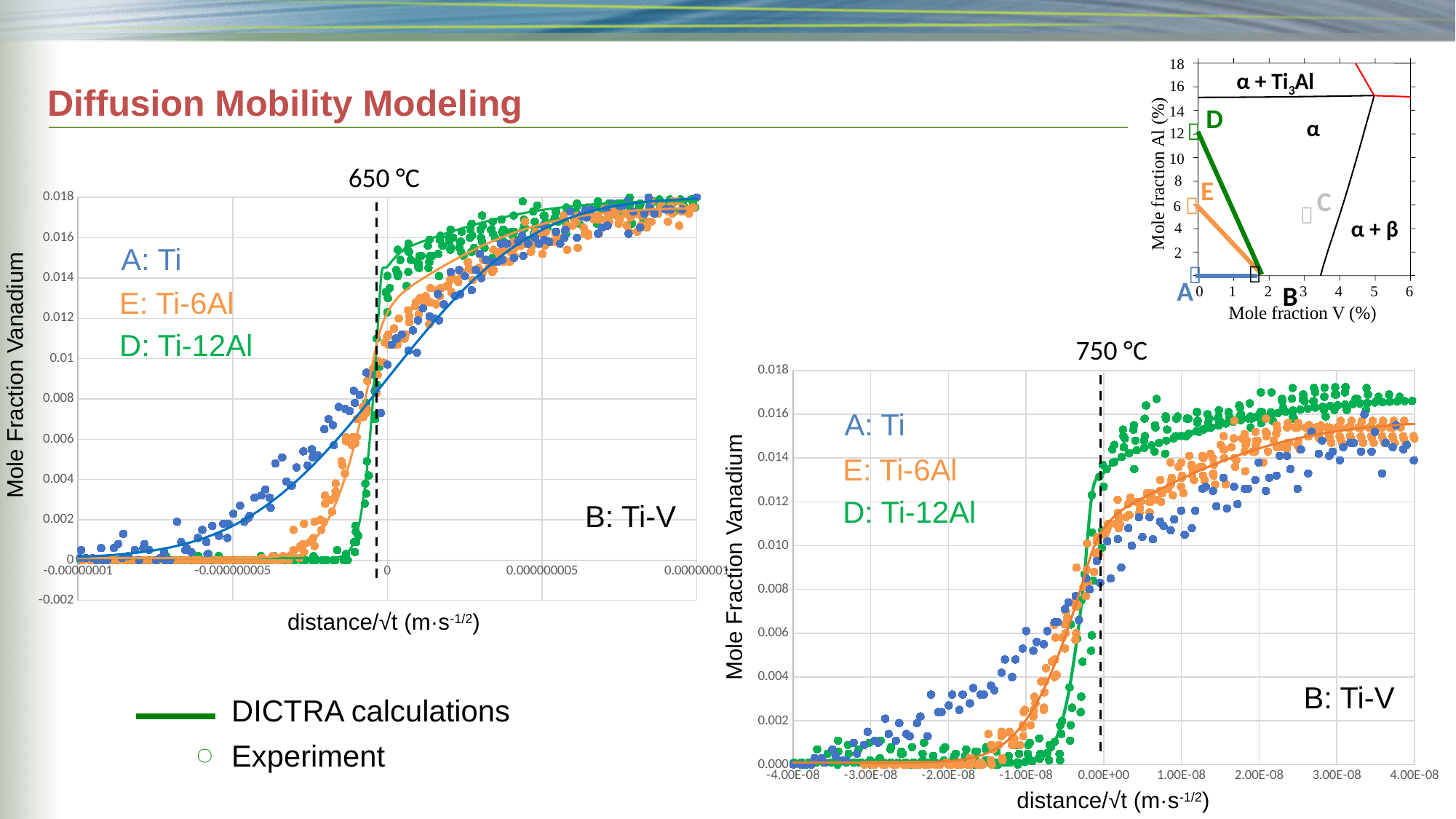
What is the y-axis label of the 750 °C chart? Mole Fraction Vanadium In the 750 °C chart, at distance/√t = 4.00E-08, is the value for D: Ti-12Al greater or less than 0.014? greater In the 650 °C chart, at distance/√t = 0, is the value for D: Ti-12Al greater or less than 0.012? greater According to the legend at the bottom left, what do the solid lines represent? DICTRA calculations In the 650 °C chart, do the values for A: Ti rise or fall as distance/√t increases? rise In the 750 °C chart, at distance/√t = -3.00E-08, is the value for A: Ti greater or less than 0.004? less In the 650 °C chart, at distance/√t = 0.000000005, which series has the higher mole fraction vanadium, D: Ti-12Al or A: Ti? D: Ti-12Al In the 750 °C chart, do the values for D: Ti-12Al rise or fall along the x axis? rise What kind of chart is the 650 °C chart on the left? scatter chart In the 750 °C chart, at distance/√t = -2.00E-08, which series has the higher mole fraction vanadium, A: Ti or D: Ti-12Al? A: Ti